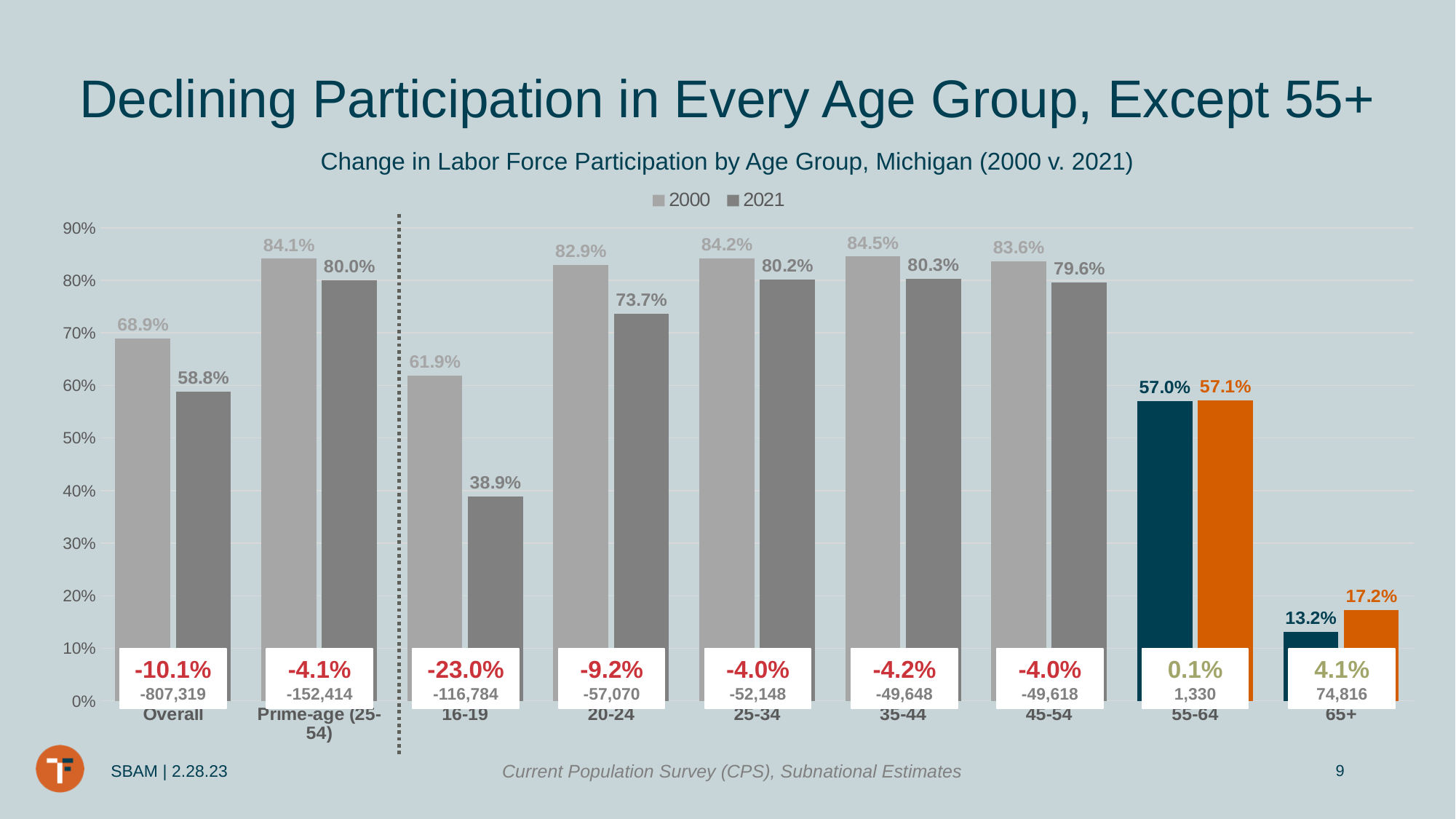
What kind of chart is shown on the slide? Bar chart How many categories are shown on the x axis of the chart? 9 How many series does the legend list? 2 What was the labor force participation rate for the 16-19 age group in 2021? 38.9% Which is larger, the 2021 participation rate for 55-64 or the 2021 participation rate for Overall? Overall Which category had the lowest labor force participation rate in 2021? 65+ Which age group had the highest labor force participation rate in 2000? 35-44 Is the 2021 participation rate for the 25-34 age group greater or less than 80%? greater What was the Overall labor force participation rate in 2000? 68.9% What was the labor force participation rate for the 45-54 age group in 2000? 83.6% What is the percentage-point change shown for the 16-19 age group? -23.0% What is the difference between the 2000 and 2021 participation rates for the 20-24 age group? 9.2 percentage points